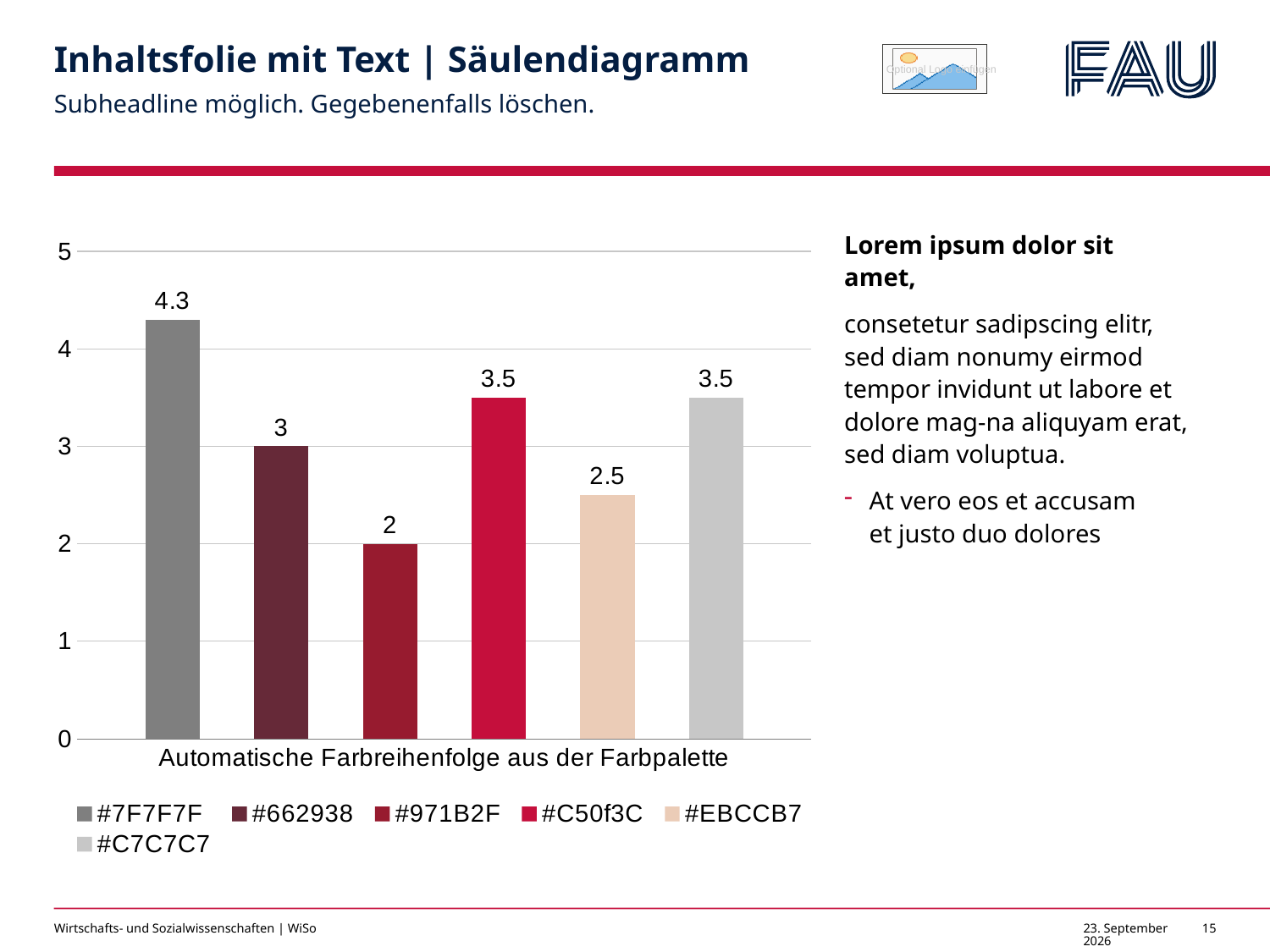
What is the value of the #C50f3C series? 3.5 What is the value of the #662938 series? 3 What is the value of the #7F7F7F series? 4.3 What is the difference between the #7F7F7F value and the #971B2F value? 2.3 Which series has the lowest value? #971B2F How many categories are shown on the x axis? 1 What is the value of the #EBCCB7 series? 2.5 What kind of chart is shown on the slide? Bar chart What is the category label shown on the x axis? Automatische Farbreihenfolge aus der Farbpalette Which is larger, the value for #662938 or the value for #EBCCB7? #662938 How many series does the legend list? 6 Which series has the highest value? #7F7F7F